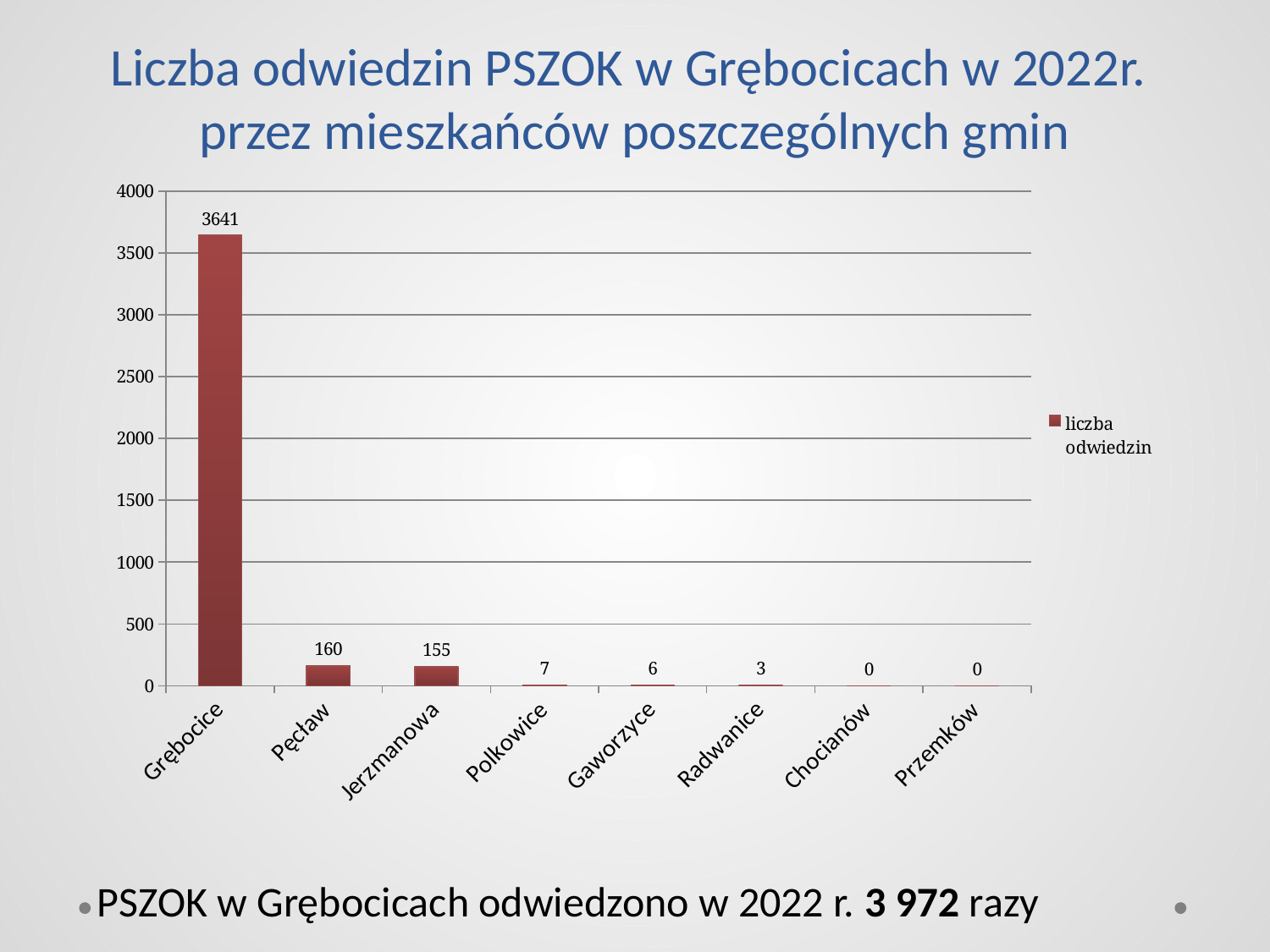
What is the number of visits (liczba odwiedzin) for Grębocice? 3641 Which has more visits, Polkowice or Gaworzyce? Polkowice Which municipality has the highest number of visits? Grębocice What is the number of visits for Jerzmanowa? 155 How many municipalities are shown on the x axis? 8 Is the value for Grębocice greater or less than 3500? greater What series name is listed in the legend? liczba odwiedzin What is the number of visits for Polkowice? 7 What type of chart is shown on the slide? bar chart What is the number of visits for Pęcław? 160 What is the number of visits for Radwanice? 3 What is the difference in visits between Pęcław and Jerzmanowa? 5